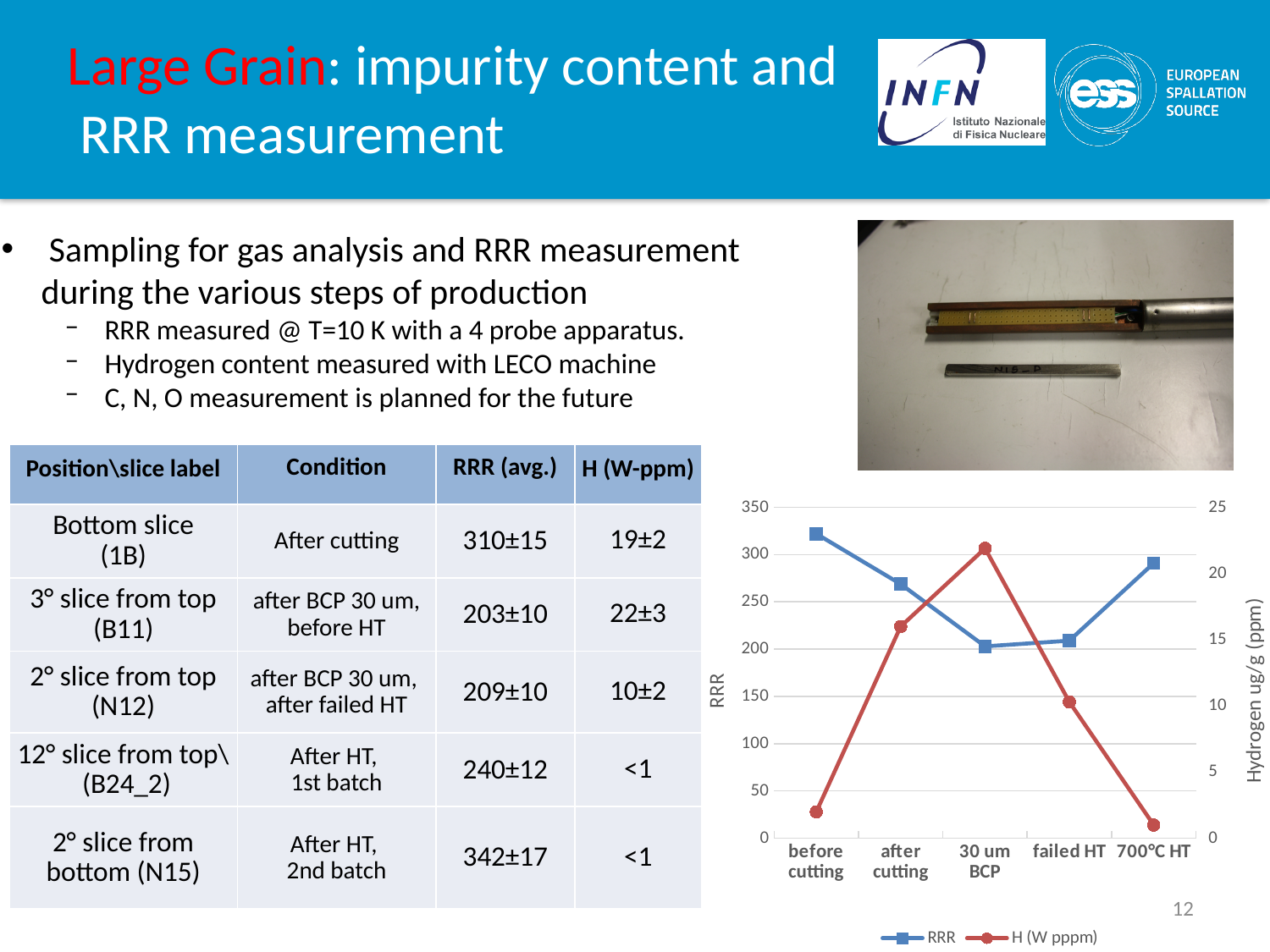
What kind of chart is shown on the slide? line chart How many categories are shown along the x axis of the chart? 5 Is the H (W pppm) value for failed HT greater or less than 15? less Is the RRR value for 30 um BCP greater or less than 250? less What is the label of the right-hand vertical axis of the chart? Hydrogen ug/g (ppm) Which category has the highest H (W pppm) value in the chart? 30 um BCP How many series does the chart legend list? 2 Is the RRR value for before cutting greater or less than 300? greater Does the RRR series rise or fall from before cutting to 30 um BCP? fall Which has the larger RRR value, 700°C HT or 30 um BCP? 700°C HT Which category has the highest RRR value in the chart? before cutting